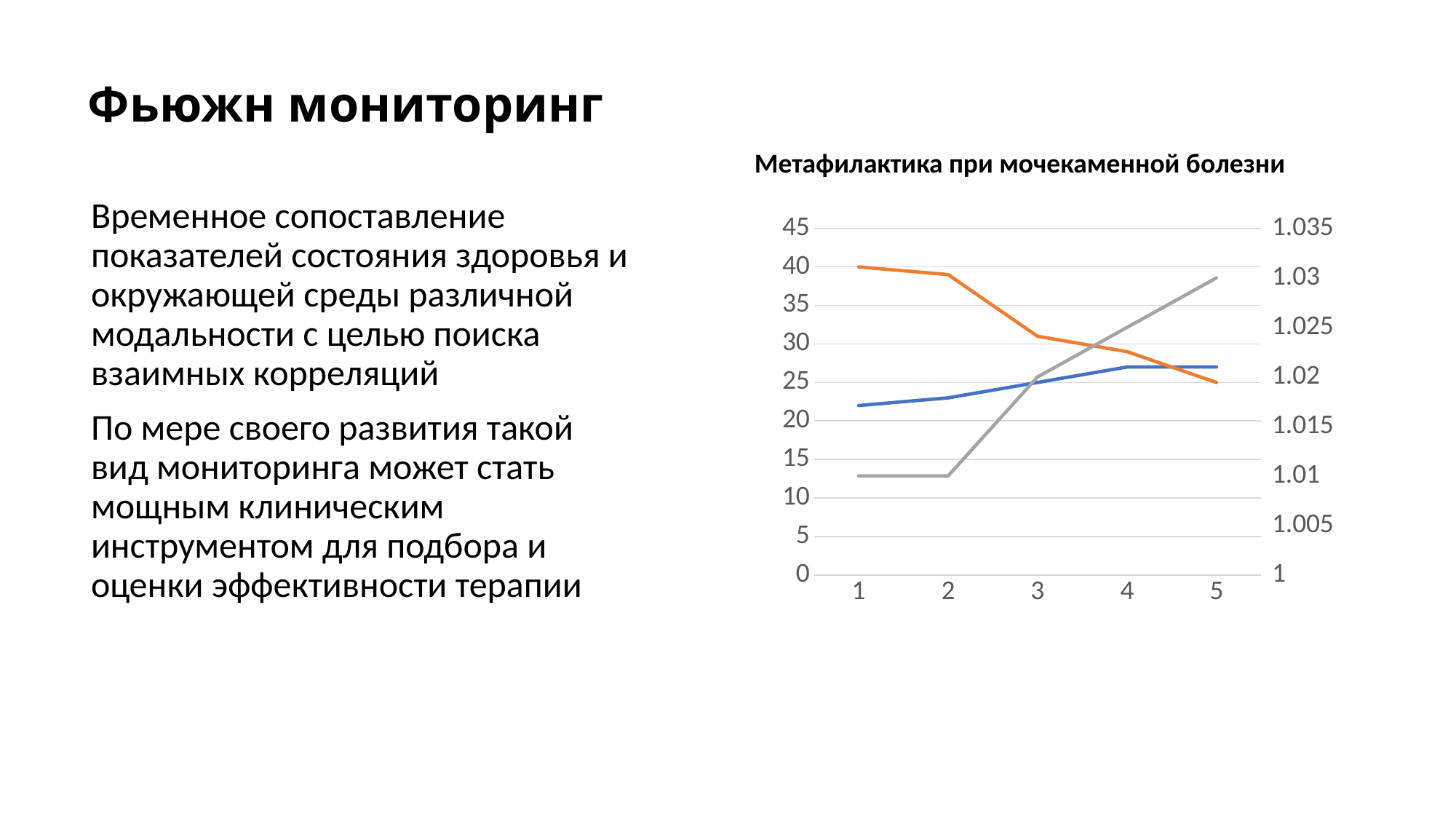
On the left axis, is the value of the orange line at x = 2 greater or less than 35? greater On the left axis, is the value of the blue line at x = 1 greater or less than 20? greater Does the blue line rise or fall from x = 1 to x = 5? rise How many lines are plotted on the chart? 3 At x = 1, which line is higher on the chart, the orange line or the blue line? orange line How many points are marked along the x axis of the chart? 5 Does the orange line rise or fall from x = 1 to x = 5? fall What is the title of the chart? Метафилактика при мочекаменной болезни Does the gray line rise or fall from x = 2 to x = 5? rise What kind of chart is shown on the slide? line chart How many vertical axes does the chart have? 2